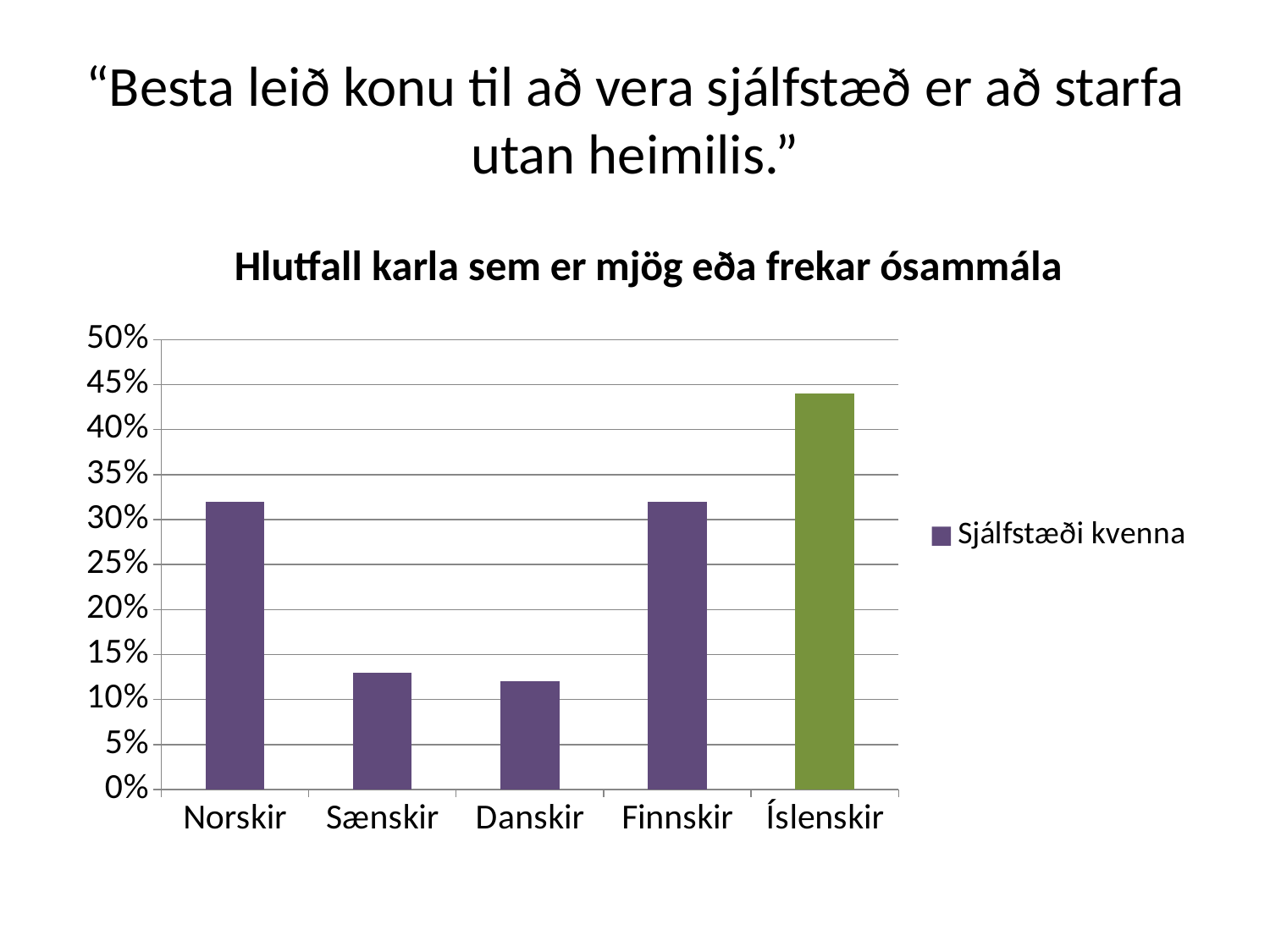
How many categories are shown on the x axis of the chart? 5 Which is larger, the value for Finnskir or the value for Danskir? Finnskir Is the value for Íslenskir greater or less than 40%? greater Is the value for Norskir greater or less than 30%? greater How many series does the chart's legend list? 1 Is the value for Danskir greater or less than 10%? greater Which category has the highest value in the chart? Íslenskir Which is larger, the value for Íslenskir or the value for Norskir? Íslenskir What is the title of the chart? Hlutfall karla sem er mjög eða frekar ósammála What kind of chart is shown on the slide? bar chart